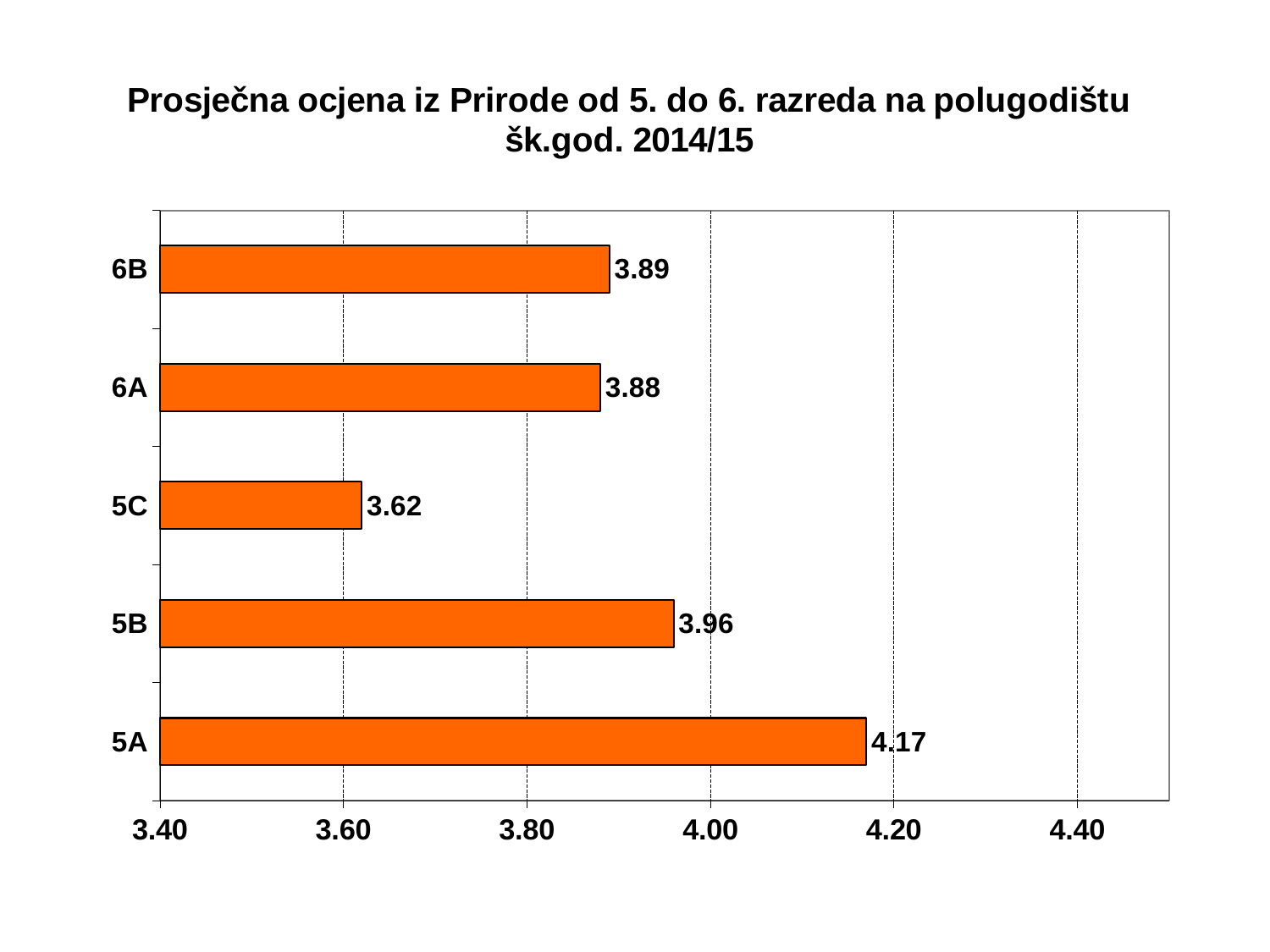
How many classes are shown in the chart? 5 Which class has the lowest average grade? 5C What is the average grade for class 5A? 4.17 What is the average grade for class 5C? 3.62 Which class has a higher average grade, 5B or 5C? 5B Which class has the highest average grade? 5A What is the average grade for class 6B? 3.89 Is the value for 6A greater or less than 4.00? less What school year does the chart title refer to? 2014/15 What kind of chart is shown on the slide? bar chart What is the difference between the average grades of 5B and 6A? 0.08 What is the difference between the average grades of 5A and 5C? 0.55